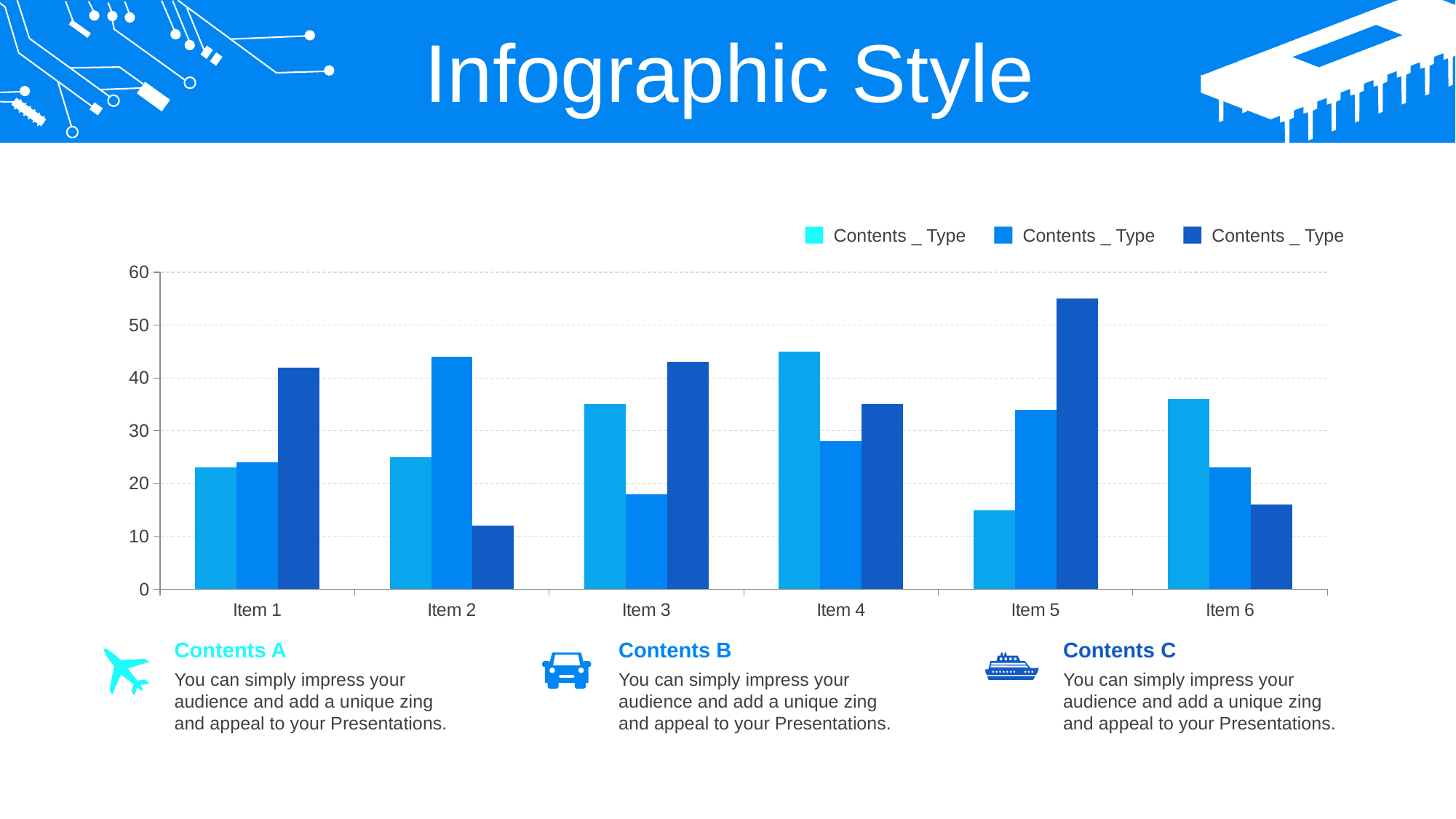
Is the dark blue bar for Item 2 greater or less than 20? less How many series does the chart's legend list? 3 For Item 6, which is larger: the light blue (first) bar or the dark blue (third) bar? the light blue bar For which item is the light blue (first) bar the shortest? Item 5 How many categories (items) are shown on the x axis of the chart? 6 For which item is the dark blue bar the tallest? Item 5 For which item is the light blue (first) bar the tallest? Item 4 For Item 1, which is larger: the light blue (first) bar or the dark blue (third) bar? the dark blue bar Is the light blue (first) bar for Item 4 greater or less than 40? greater Is the dark blue bar for Item 5 greater or less than 50? greater What kind of chart is shown on the slide? bar chart For which item is the dark blue bar the shortest? Item 2